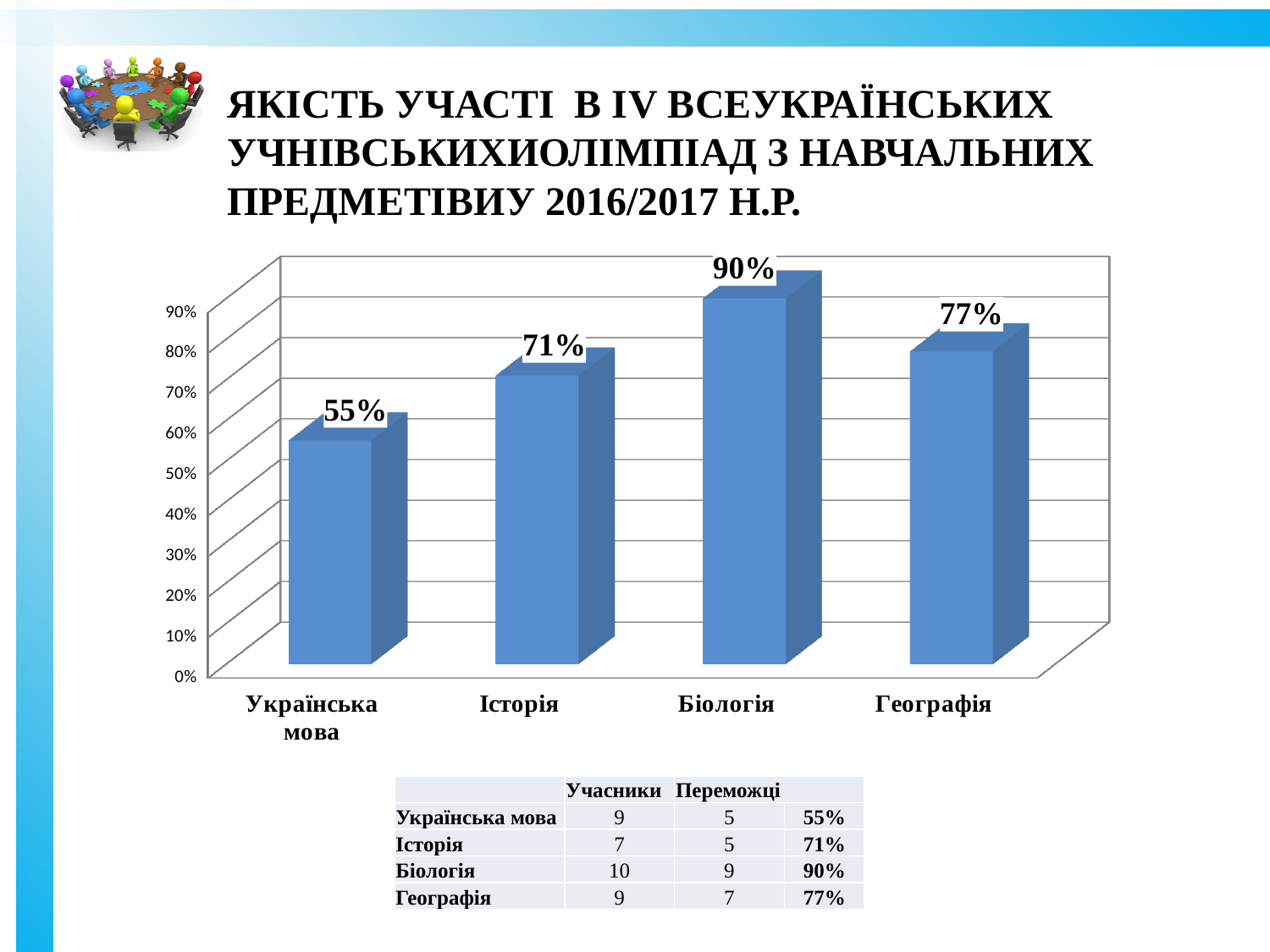
What is the difference between the values for Географія and Історія? 6% Which is larger, the value for Історія or the value for Географія? Географія What is the value shown for Історія? 71% What is the value shown for Українська мова? 55% What is the value shown for Географія? 77% Which category has the highest value? Біологія What is the difference between the values for Біологія and Українська мова? 35% What is the value shown for Біологія? 90% How many categories are shown on the x axis? 4 Is the value for Історія greater or less than 60%? greater Which category has the lowest value? Українська мова What kind of chart is shown on the slide? bar chart